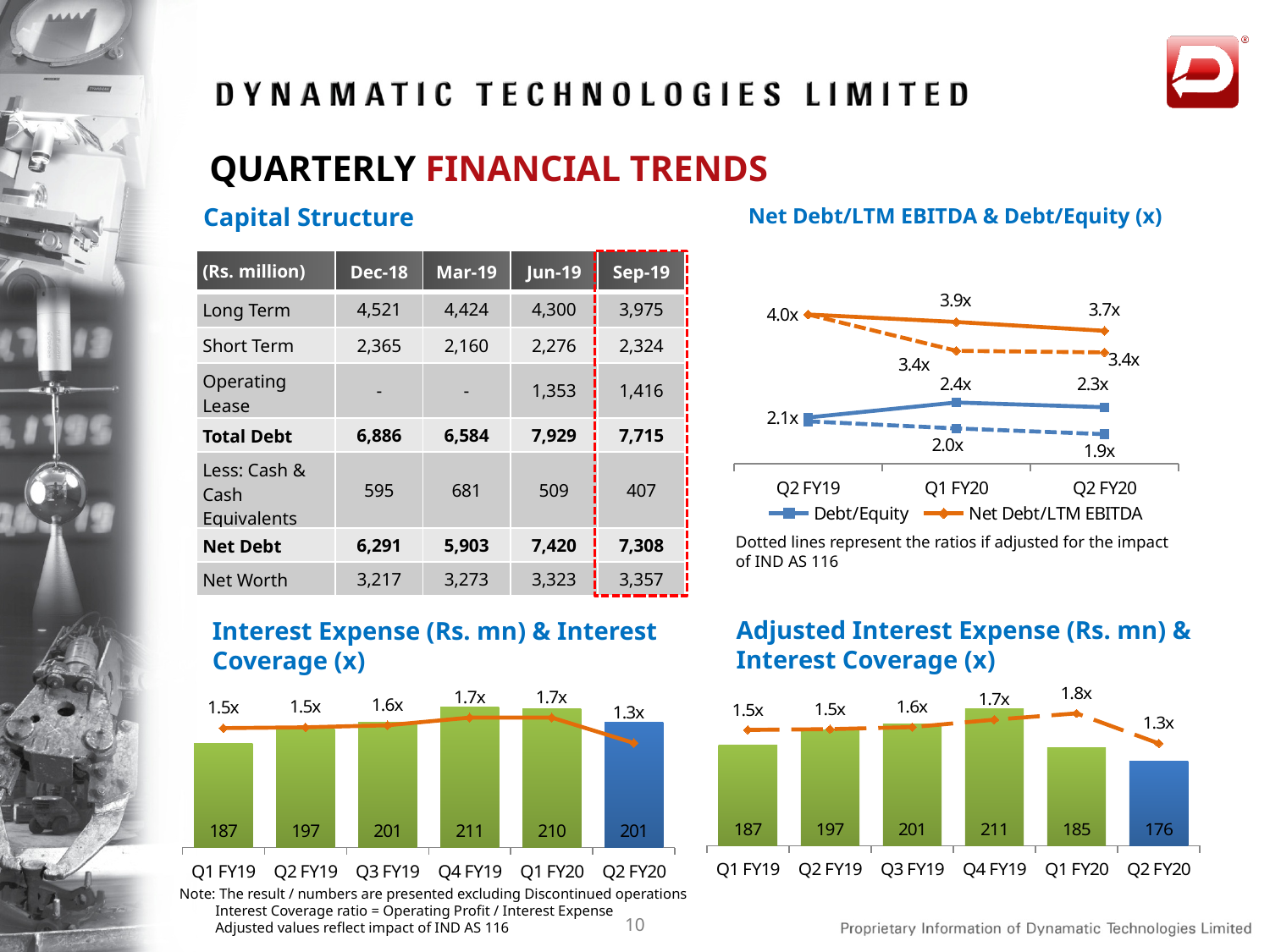
In the Net Debt/LTM EBITDA & Debt/Equity chart, what do the dotted lines represent? The ratios if adjusted for the impact of IND AS 116 In the Adjusted Interest Expense (Rs. mn) & Interest Coverage (x) chart, what is the interest coverage ratio for Q1 FY20? 1.8x In the Net Debt/LTM EBITDA & Debt/Equity chart, how many quarters are shown on the x axis? 3 In the Adjusted Interest Expense (Rs. mn) & Interest Coverage (x) chart, which quarter has the highest adjusted interest expense? Q4 FY19 In the Net Debt/LTM EBITDA & Debt/Equity chart, what is the Net Debt/LTM EBITDA value (solid line) for Q1 FY20? 3.9x In the Interest Expense (Rs. mn) & Interest Coverage (x) chart, what is the interest coverage ratio for Q2 FY20? 1.3x In the Interest Expense (Rs. mn) & Interest Coverage (x) chart, which quarter has the lowest interest expense? Q1 FY19 In the Adjusted Interest Expense (Rs. mn) & Interest Coverage (x) chart, what is the adjusted interest expense for Q2 FY20? 176 In the Interest Expense (Rs. mn) & Interest Coverage (x) chart, what is the interest expense for Q4 FY19? 211 In the Net Debt/LTM EBITDA & Debt/Equity chart, how many series does the legend list? 2 In the Net Debt/LTM EBITDA & Debt/Equity chart, what is the Debt/Equity value (solid line) for Q2 FY19? 2.1x In the Interest Expense (Rs. mn) & Interest Coverage (x) chart, what is the difference in interest expense between Q4 FY19 and Q1 FY19? 24